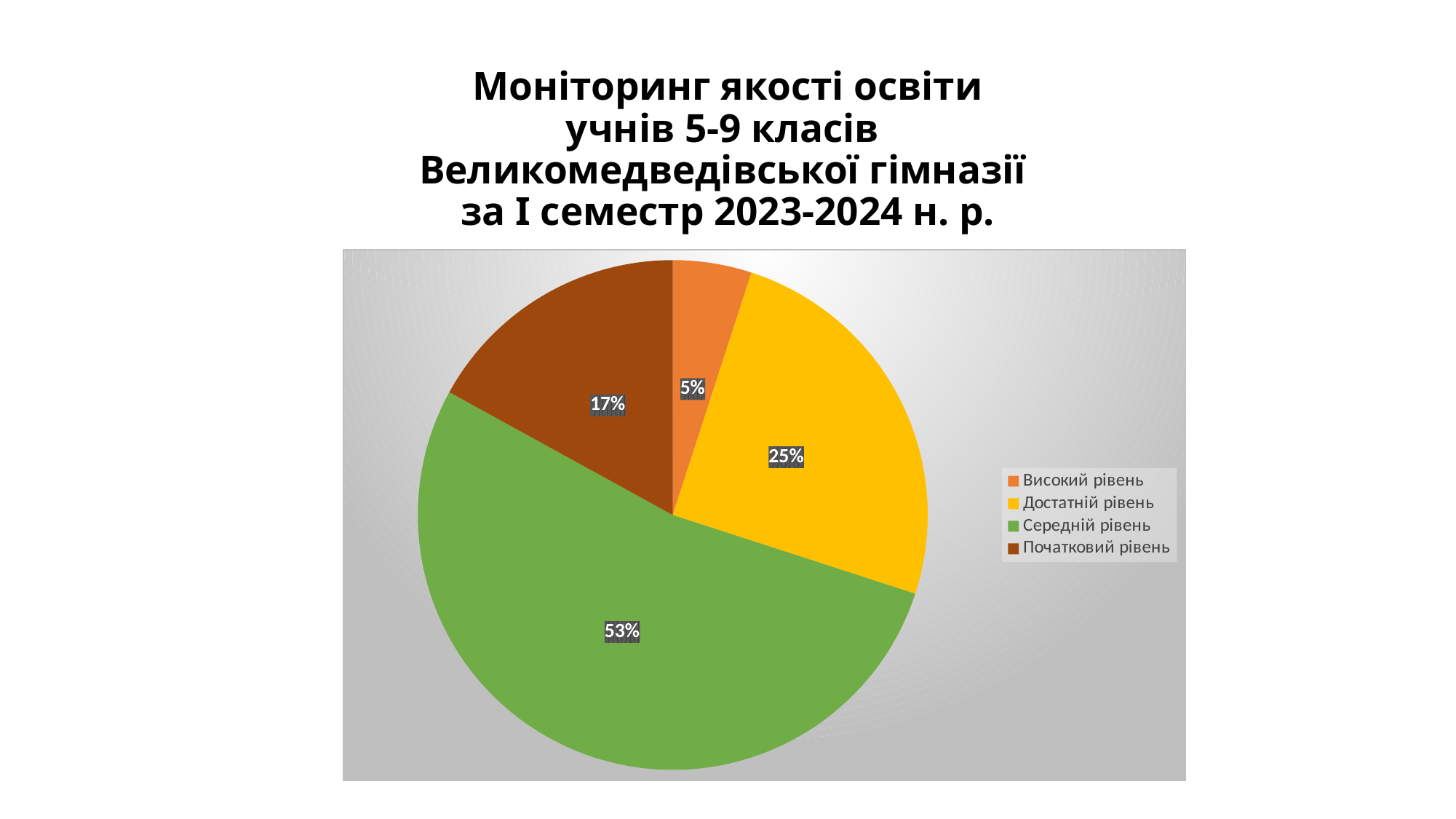
Which category has the smallest slice of the pie? Високий рівень Which category has the largest slice of the pie? Середній рівень What share of the pie is labelled for Початковий рівень? 17% What colour is the slice for Середній рівень? green What share of the pie is labelled for Достатній рівень? 25% Which is larger, the slice for Достатній рівень or the slice for Початковий рівень? Достатній рівень What share of the pie is labelled for Середній рівень? 53% How many categories does the legend list? 4 What is the difference in percentage points between Початковий рівень and Високий рівень? 12 What kind of chart is shown on the slide? pie chart What is the difference in percentage points between Середній рівень and Достатній рівень? 28